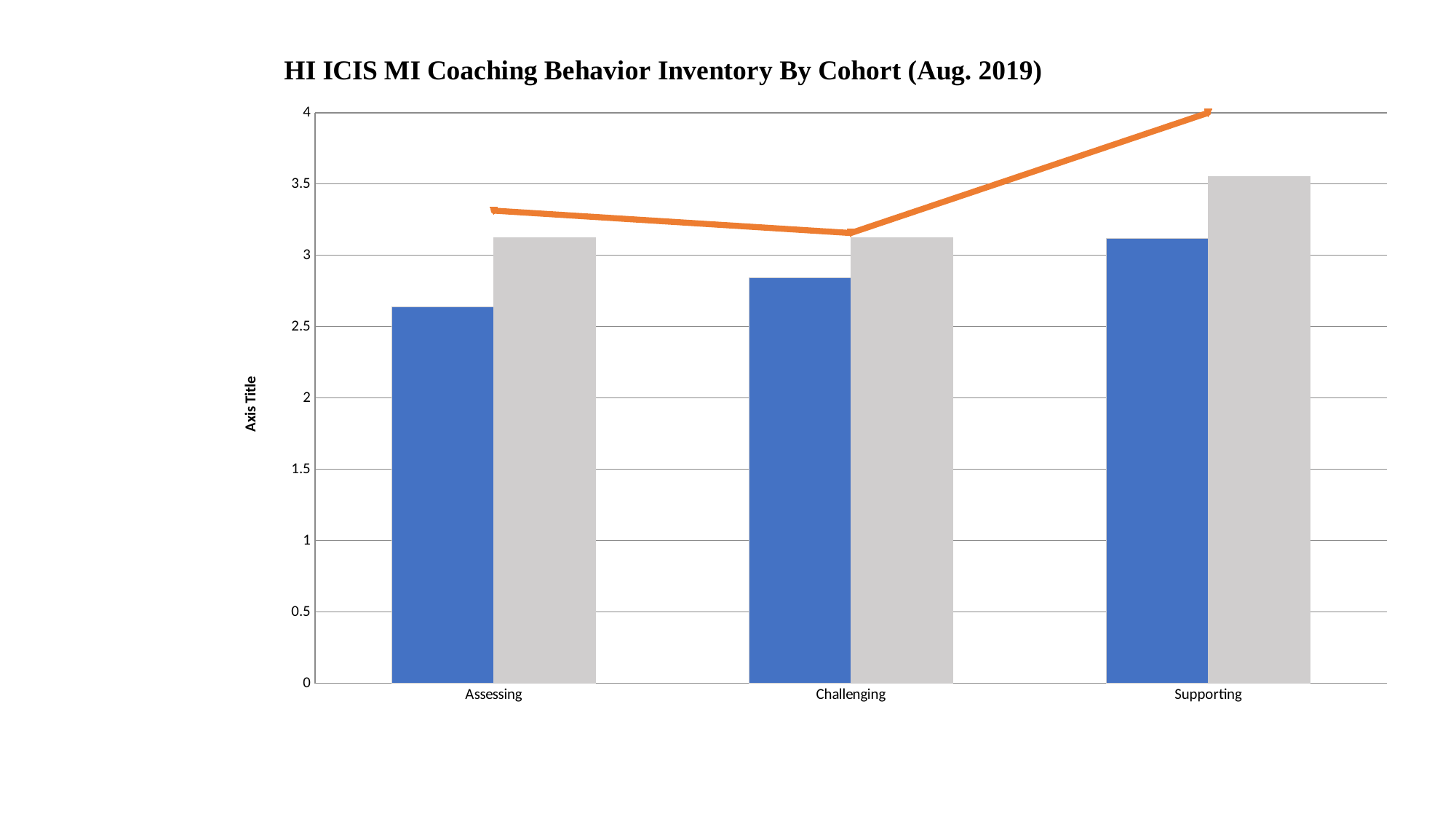
Which category has the highest blue bar? Supporting Do the blue bars rise or fall from Assessing to Supporting? rise What is the title of the chart? HI ICIS MI Coaching Behavior Inventory By Cohort (Aug. 2019) What kind of chart is this? Bar chart with a line series Is the blue bar for Challenging greater or less than 3? less Which category has the highest gray bar? Supporting For Assessing, which is larger, the blue bar or the gray bar? the gray bar How many categories are shown on the x axis? 3 Is the blue bar for Assessing greater or less than 2.5? greater At which category is the orange line at its lowest point? Challenging Which category has the lowest blue bar? Assessing